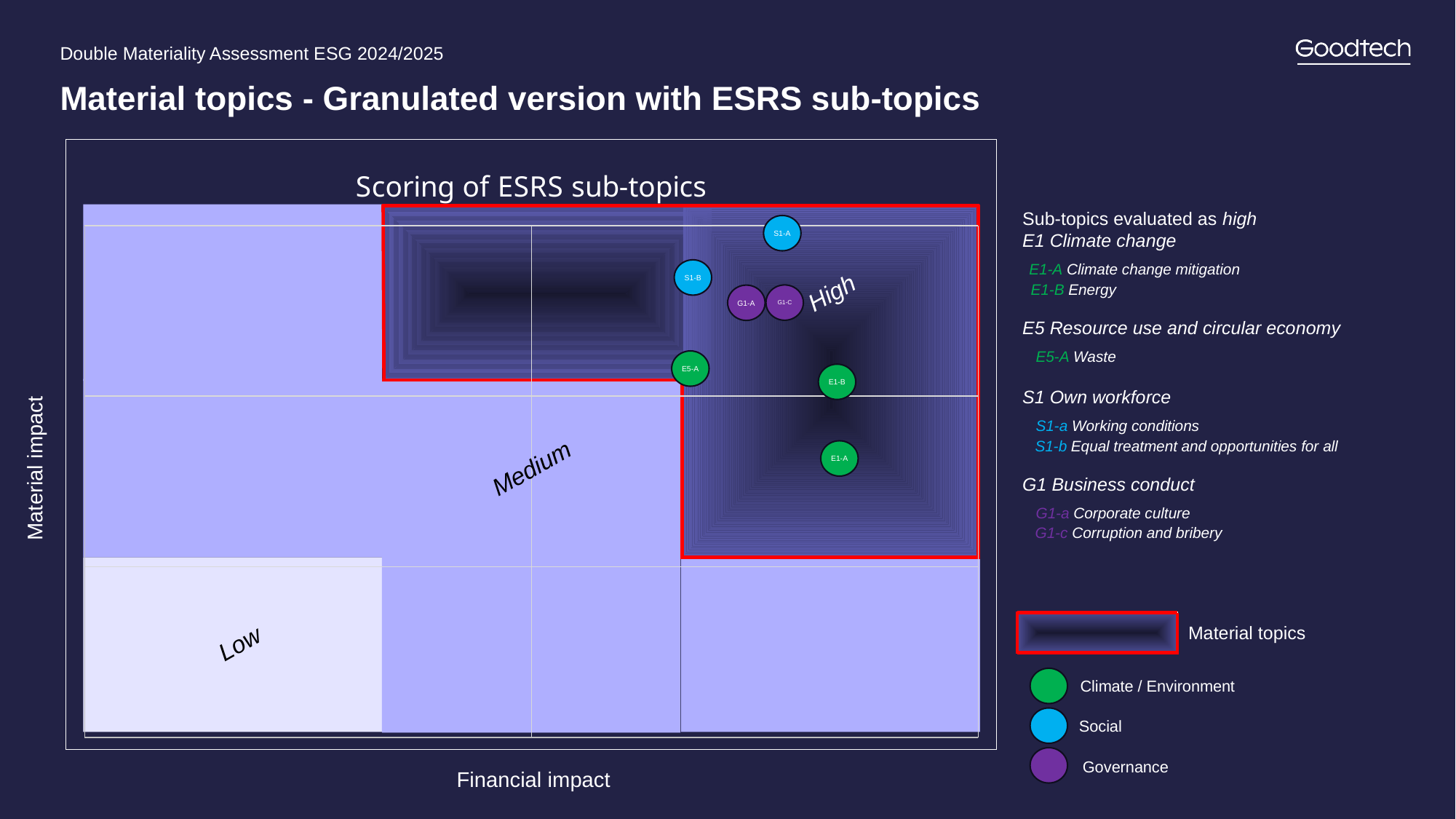
How many colour categories for sub-topics does the legend list (Climate / Environment, Social, Governance)? 3 Which sub-topic point has the lowest material impact on the chart? E1-A What is the label of the vertical axis? Material impact How many points on the chart belong to the Climate / Environment category (green)? 3 What is the title of the chart? Scoring of ESRS sub-topics How many sub-topic points are plotted on the chart? 7 What kind of chart is shown on the slide? Scatter chart Which has the higher financial impact, S1-B or E1-B? E1-B Which has the higher material impact, S1-A or E1-A? S1-A Which sub-topic point has the highest material impact on the chart? S1-A How many points on the chart belong to the Social category (blue)? 2